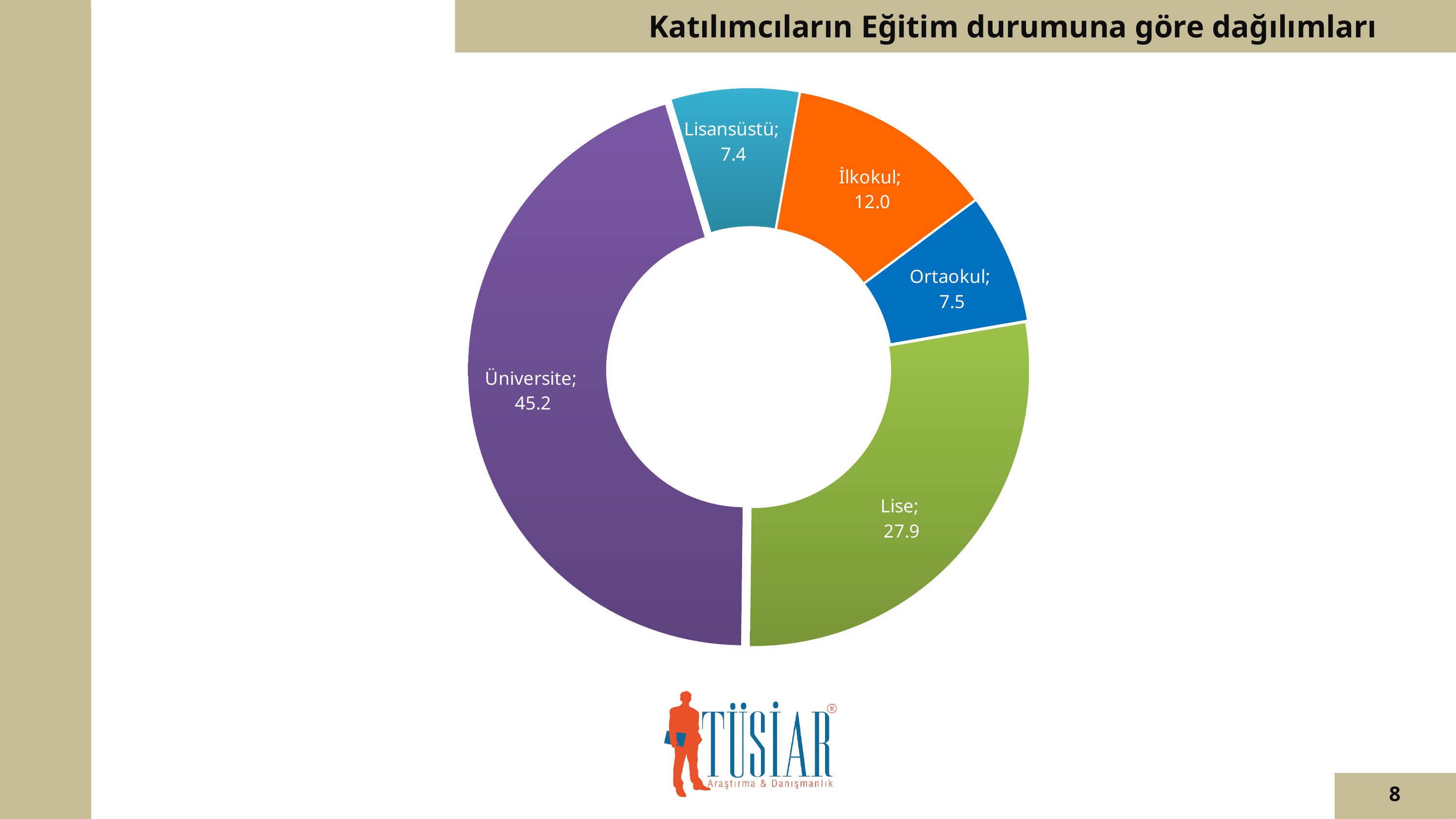
Which category has the smallest slice? Lisansüstü What is the value for Lise? 27.9 What is the value for Ortaokul? 7.5 What is the difference between the values for İlkokul and Ortaokul? 4.5 What is the difference between the values for Üniversite and Lise? 17.3 Which category has the largest slice? Üniversite What is the value for Lisansüstü? 7.4 What is the value for Üniversite? 45.2 What kind of chart is shown on the slide? doughnut chart What is the value for İlkokul? 12.0 Which is larger, Lise or İlkokul? Lise How many categories are shown in the chart? 5